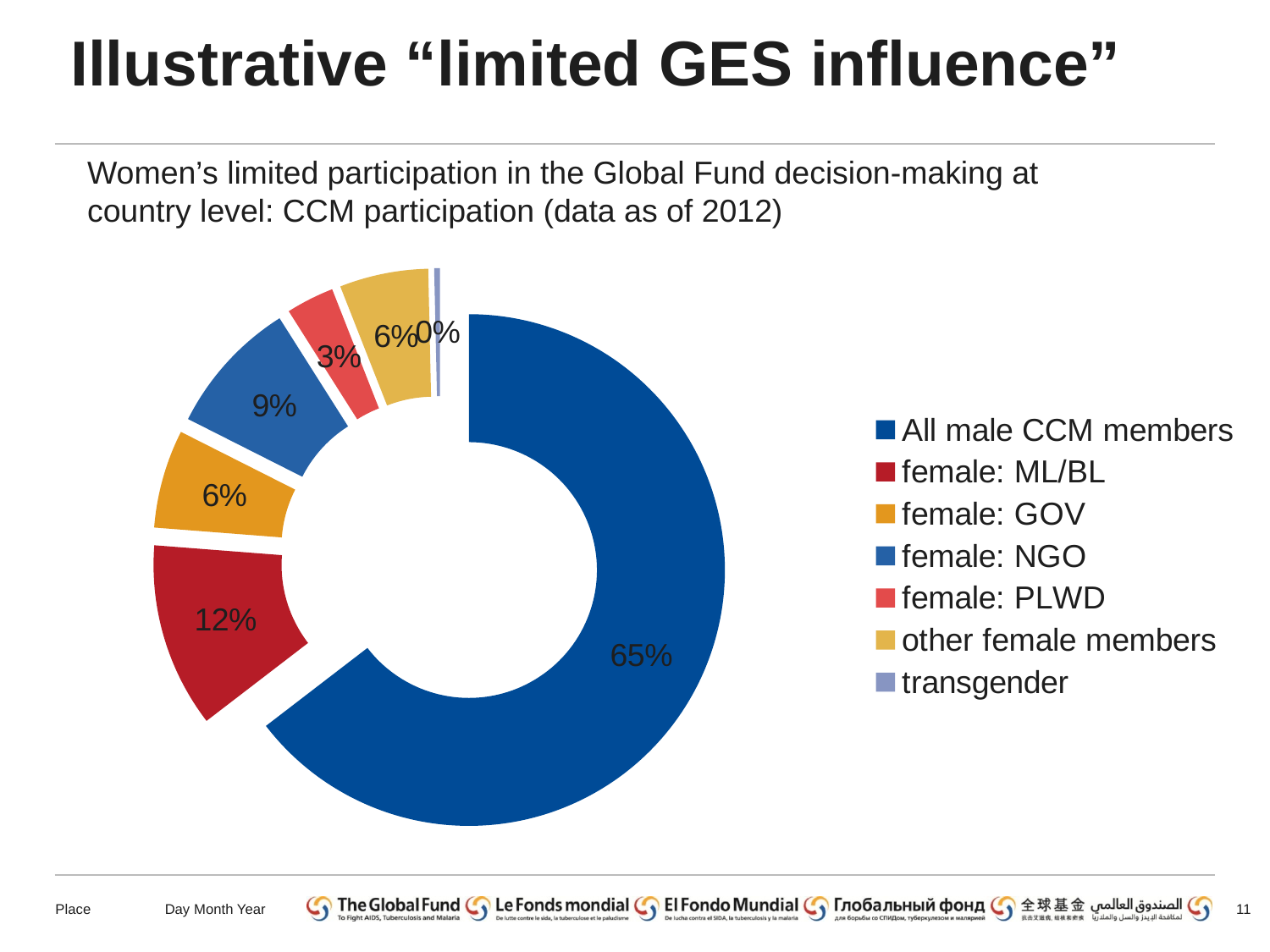
Which category has the largest share of the chart? All male CCM members Which category has the smallest share of the chart? transgender What is the difference in percentage points between All male CCM members and female: ML/BL? 53 What percentage of CCM members are all male CCM members? 65% How many categories does the legend list? 7 Which is larger, the share for female: NGO or the share for female: PLWD? female: NGO What colour is the slice for All male CCM members? Blue What percentage is shown for transgender? 0% What percentage is shown for female: NGO? 9% What kind of chart is shown on the slide? Pie chart (doughnut) What share of the chart is female: ML/BL? 12% What percentage is shown for female: PLWD? 3%